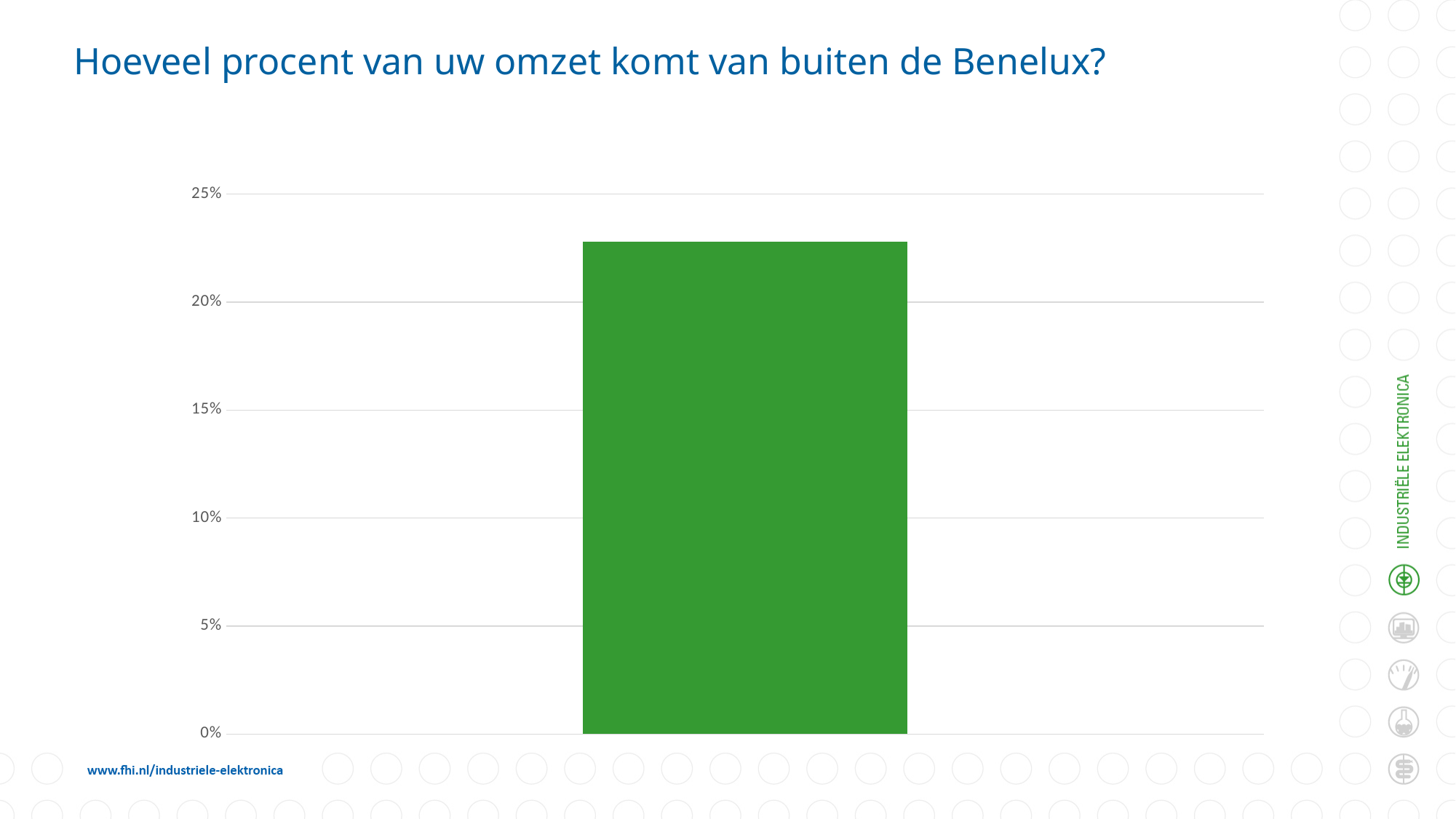
How many bars are plotted in the chart? 1 What colour is the bar in the chart? green What is the title of the chart on the slide? Hoeveel procent van uw omzet komt van buiten de Benelux? What kind of chart is shown on the slide? bar chart Is the value of the bar greater or less than 20%? greater Is the value of the bar greater or less than 25%? less Is the value of the bar greater or less than 15%? greater